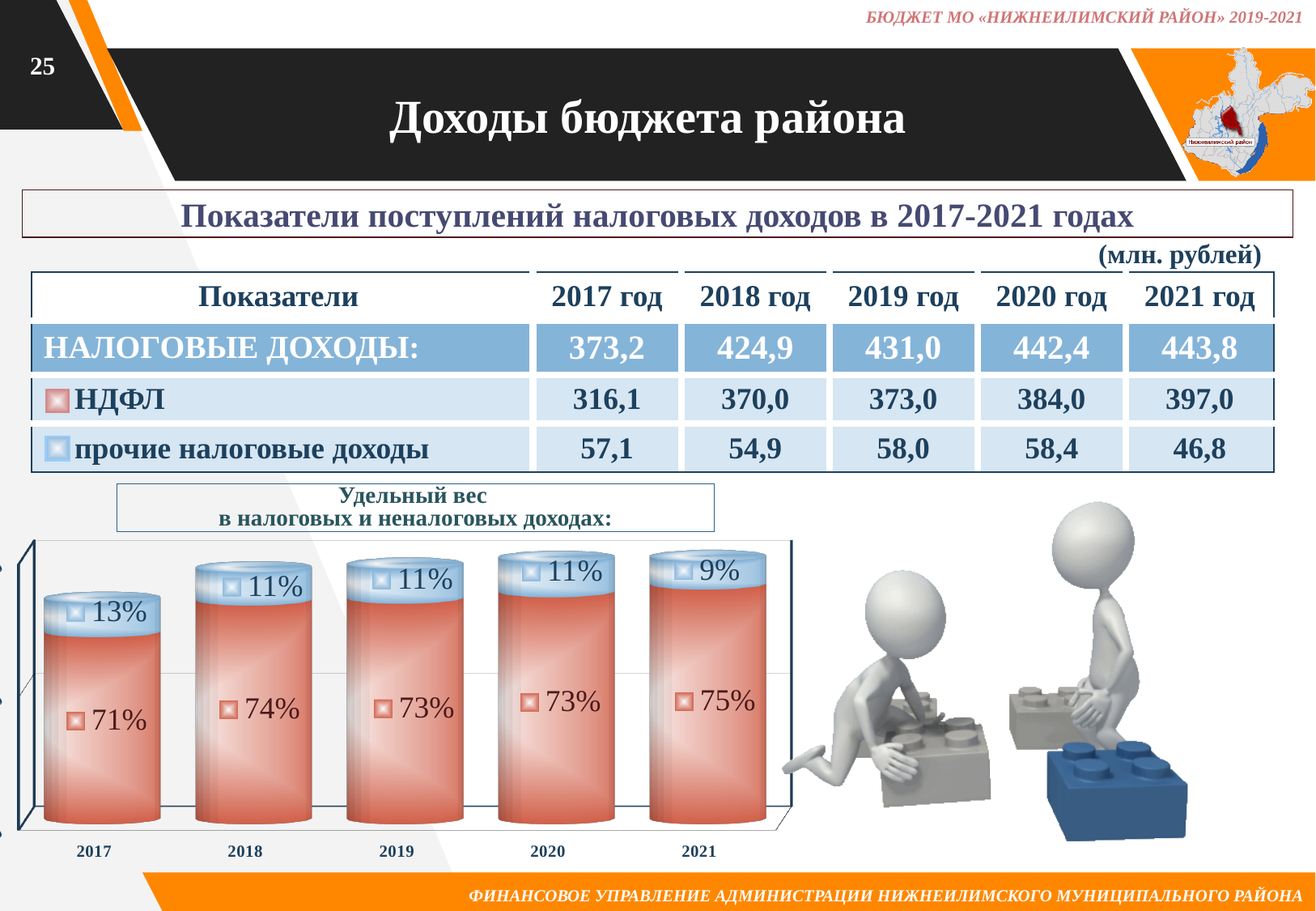
In the bar chart, what is the value of the red (НДФЛ) segment for 2017? 71% In the bar chart, which year has the lowest value for the blue (прочие налоговые доходы) segment? 2021 In the bar chart, what is the difference between the blue segment values for 2017 and 2021? 4 percentage points In the bar chart, what is the value of the blue (прочие налоговые доходы) segment for 2021? 9% What kind of chart is shown at the bottom left of the slide? bar chart What is the title shown above the bar chart? Удельный вес в налоговых и неналоговых доходах: In the bar chart, which year has the highest value for the red (НДФЛ) segment? 2021 In the bar chart, what is the total of the two segments of the 2017 bar? 84% In the bar chart, does the blue (прочие налоговые доходы) segment rise or fall from 2017 to 2021? fall How many years are shown along the x axis of the bar chart? 5 In the bar chart, what is the value of the red (НДФЛ) segment for 2020? 73%